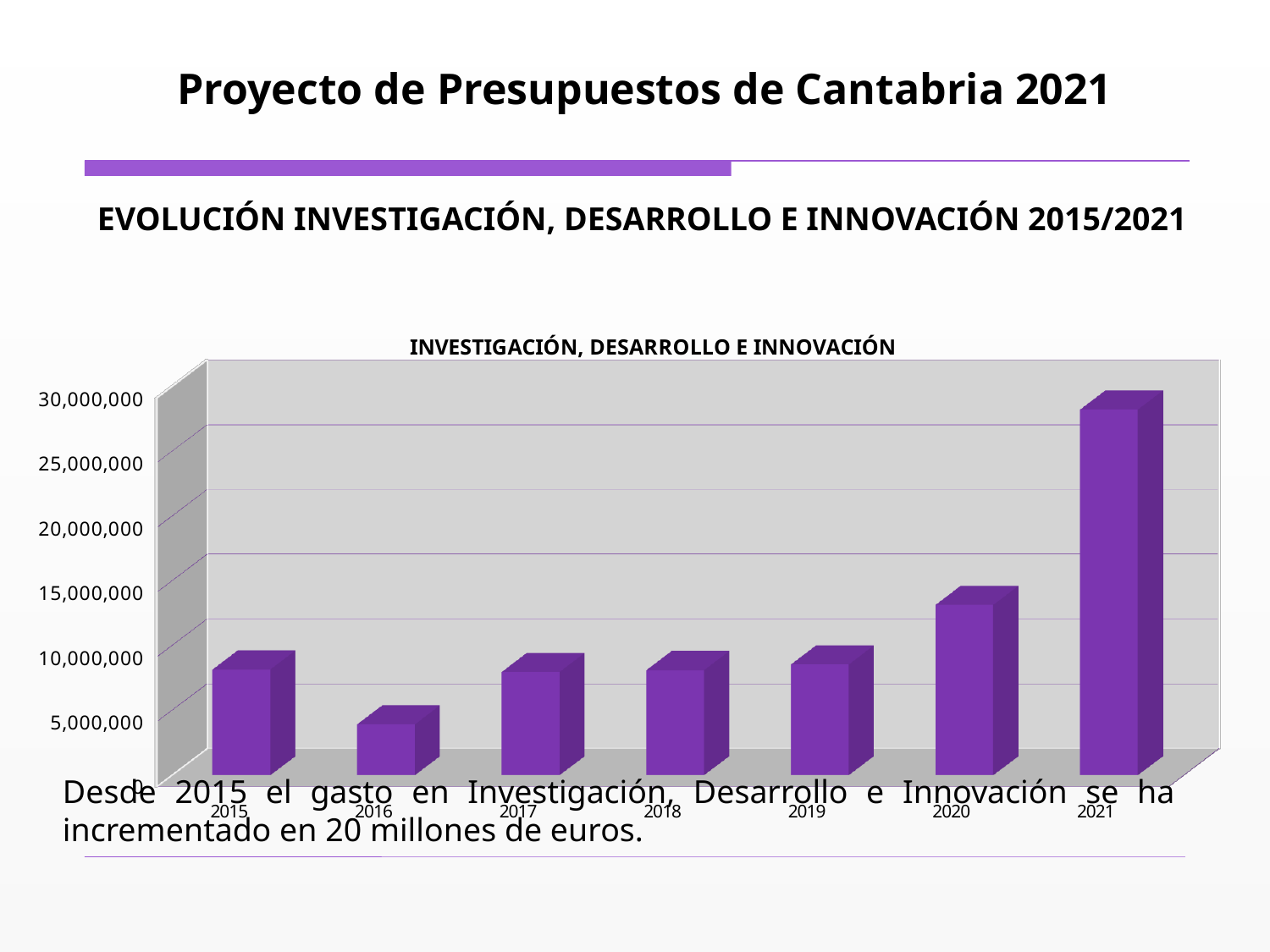
Is the value for 2021 greater or less than 20,000,000? greater Is the value for 2020 greater or less than 10,000,000? greater What kind of chart is shown on the slide? bar chart Which year has the highest value in the chart? 2021 Which is larger, the value for 2020 or the value for 2021? 2021 Is the value for 2015 greater or less than 5,000,000? greater Which is larger, the value for 2015 or the value for 2016? 2015 Which year has the lowest value in the chart? 2016 What is the title of the chart? INVESTIGACIÓN, DESARROLLO E INNOVACIÓN Do the values rise or fall from 2019 to 2021? rise How many years are plotted on the x axis of the chart? 7